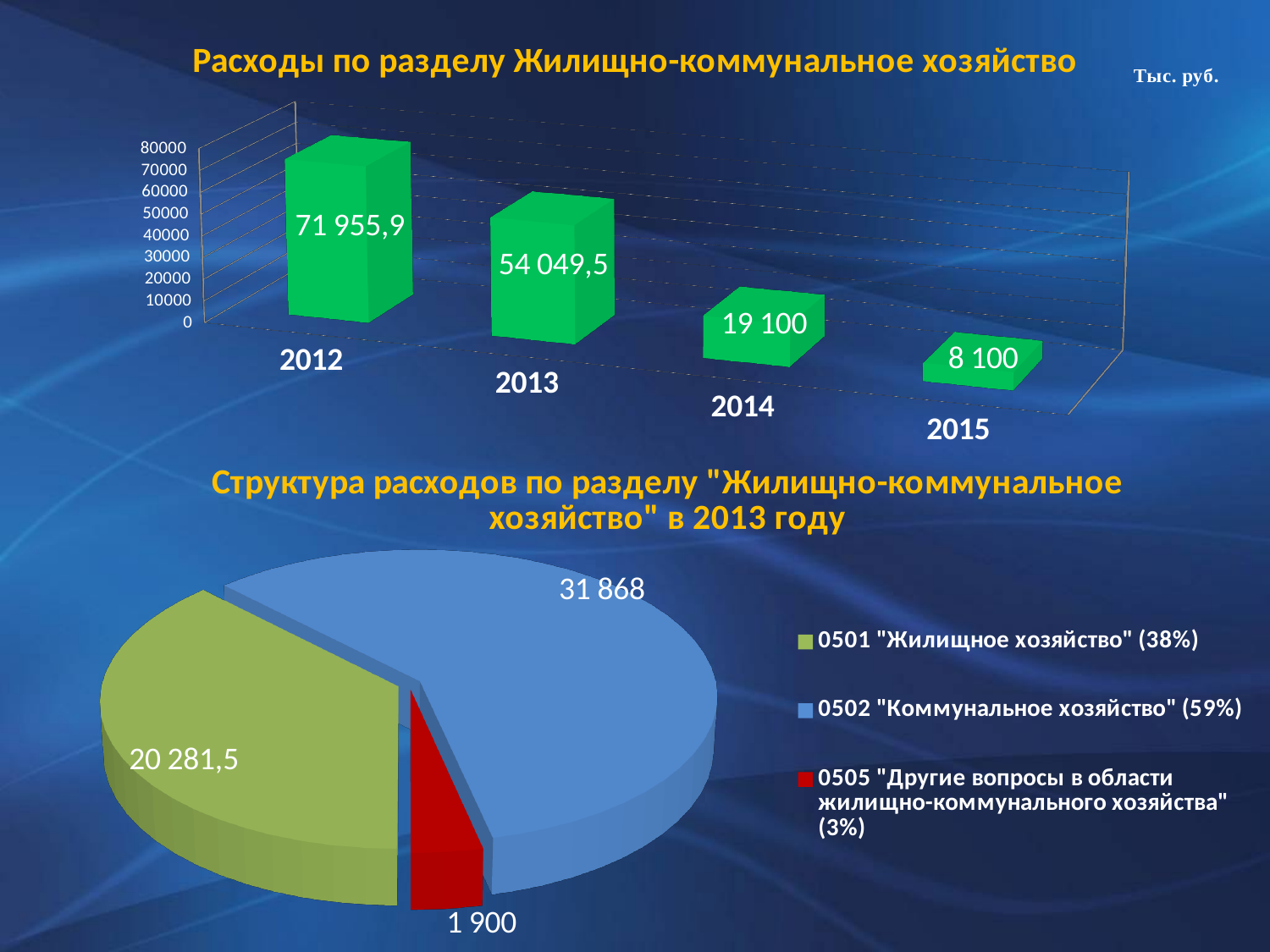
In the top chart 'Расходы по разделу Жилищно-коммунальное хозяйство', how many years are shown? 4 In the top chart 'Расходы по разделу Жилищно-коммунальное хозяйство', do the values rise or fall from 2012 to 2015? fall In the bottom pie chart 'Структура расходов по разделу Жилищно-коммунальное хозяйство в 2013 году', what share does 0501 'Жилищное хозяйство' have? 38% In the top chart 'Расходы по разделу Жилищно-коммунальное хозяйство', what is the value for 2012? 71 955,9 In the top chart 'Расходы по разделу Жилищно-коммунальное хозяйство', what is the value for 2014? 19 100 In the top chart 'Расходы по разделу Жилищно-коммунальное хозяйство', which year has the highest value? 2012 In the bottom pie chart 'Структура расходов по разделу Жилищно-коммунальное хозяйство в 2013 году', how many entries does the legend list? 3 In the bottom pie chart 'Структура расходов по разделу Жилищно-коммунальное хозяйство в 2013 году', what is the value for 0502 'Коммунальное хозяйство'? 31 868 In the bottom pie chart 'Структура расходов по разделу Жилищно-коммунальное хозяйство в 2013 году', which category is the smallest? 0505 "Другие вопросы в области жилищно-коммунального хозяйства" In the top chart 'Расходы по разделу Жилищно-коммунальное хозяйство', which year has the lowest value? 2015 What kind of chart is the top chart 'Расходы по разделу Жилищно-коммунальное хозяйство'? bar chart In the top chart 'Расходы по разделу Жилищно-коммунальное хозяйство', what is the difference between the 2012 and 2013 values? 17 906,4